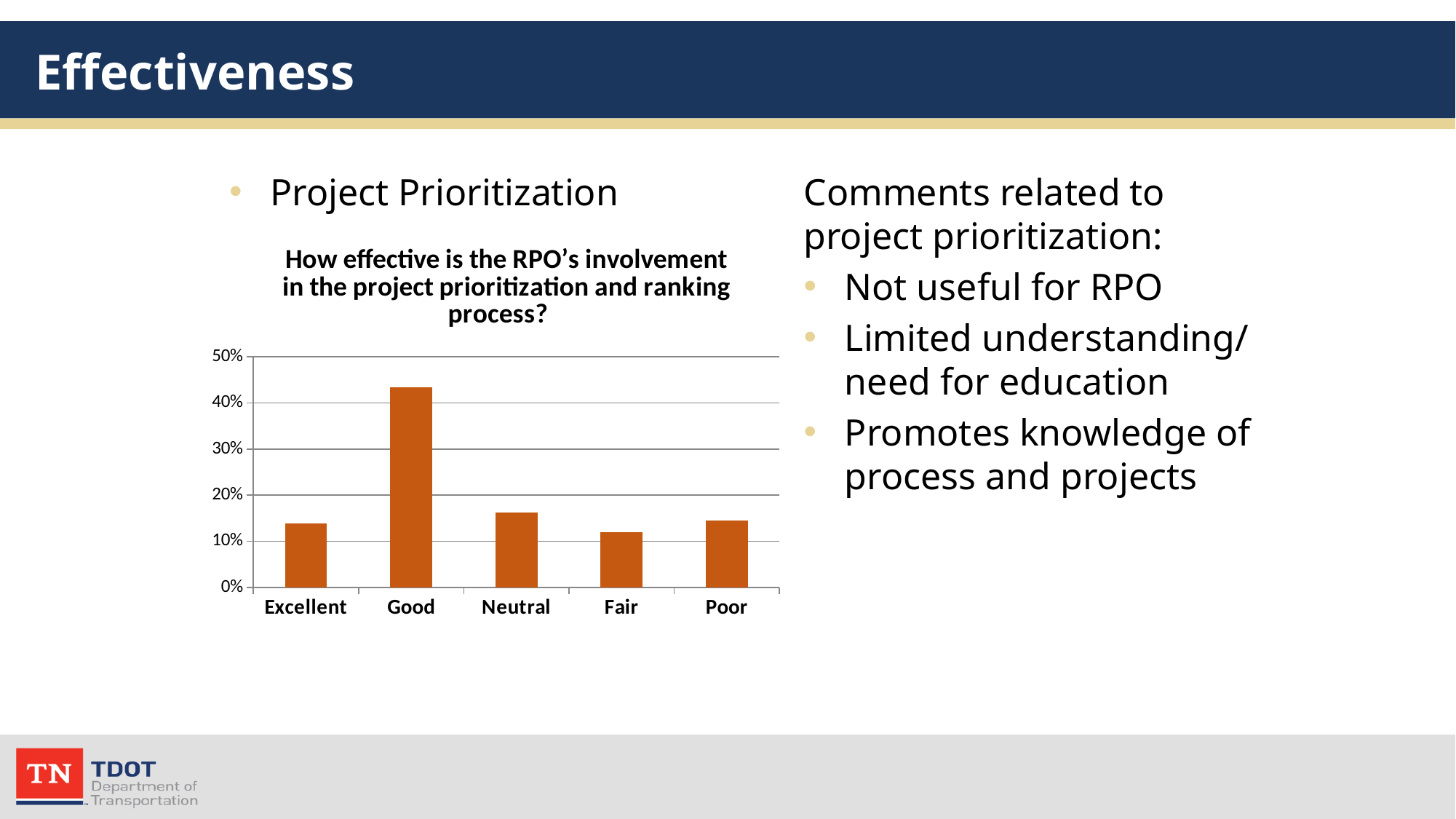
Which category has the highest value in the chart? Good Is the value for Good greater or less than 50%? less Is the value for Poor greater or less than 20%? less Which is larger, the value for Good or the value for Neutral? Good What is the title of the chart? How effective is the RPO's involvement in the project prioritization and ranking process? What is the highest value shown on the y axis of the chart? 50% What type of chart is shown on the slide? bar chart Is the value for Excellent greater or less than 20%? less How many categories are shown on the x axis of the chart? 5